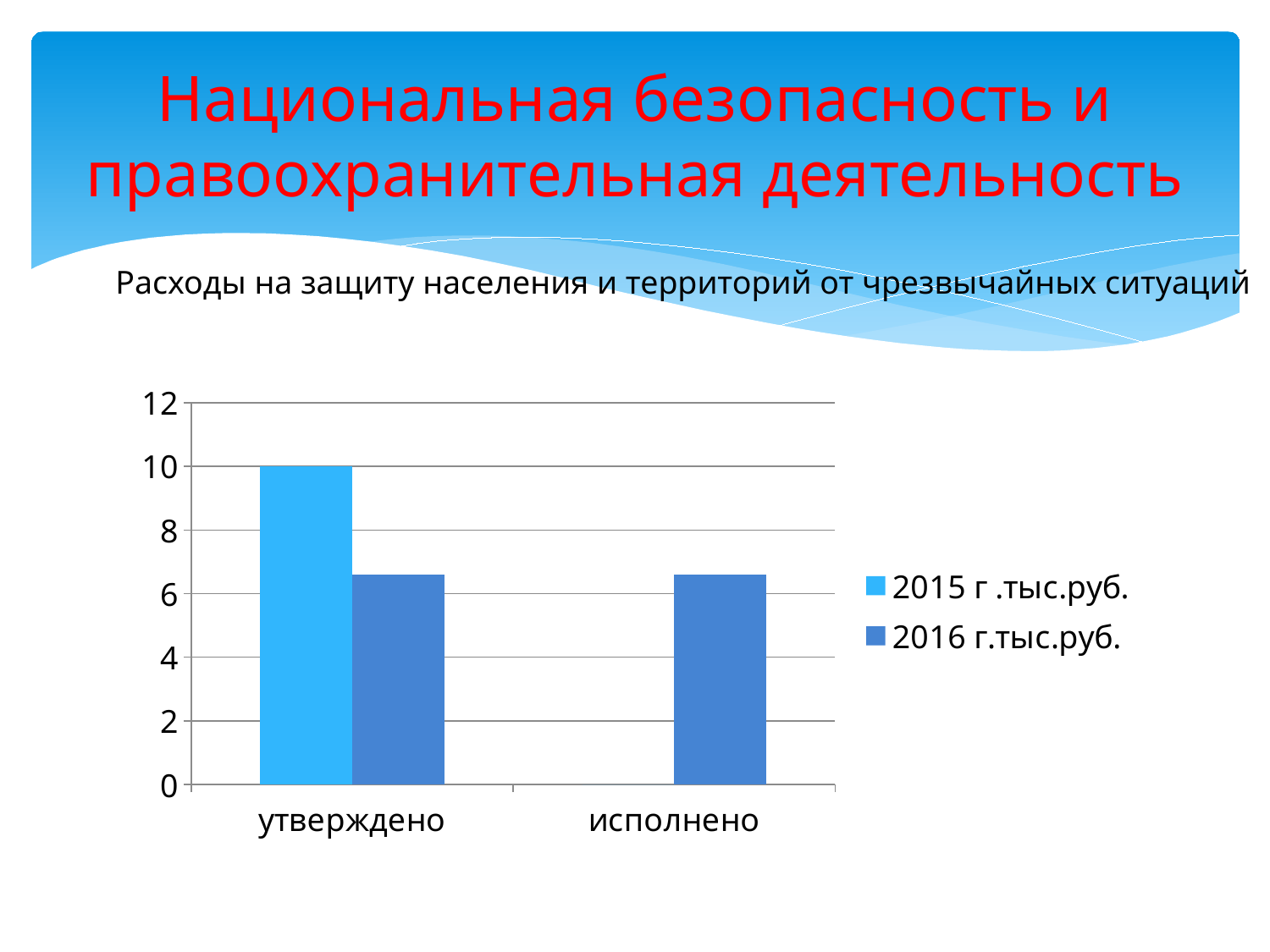
Is the value for 2016 г.тыс.руб. in the утверждено category greater or less than 8? less Is the value for 2016 г.тыс.руб. in the исполнено category greater or less than 8? less Is the value for 2016 г.тыс.руб. in the утверждено category greater or less than 6? greater What is the value for 2015 г .тыс.руб. in the утверждено category? 10 How many series does the chart legend list? 2 What kind of chart is shown on the slide? bar chart In the утверждено category, which series has the larger value, 2015 г .тыс.руб. or 2016 г.тыс.руб.? 2015 г .тыс.руб. Which category has the highest bar in the chart? утверждено What are the two entries listed in the chart legend? 2015 г .тыс.руб. and 2016 г.тыс.руб. How many categories are shown on the x axis of the chart? 2 What is the subtitle describing the chart on the slide? Расходы на защиту населения и территорий от чрезвычайных ситуаций